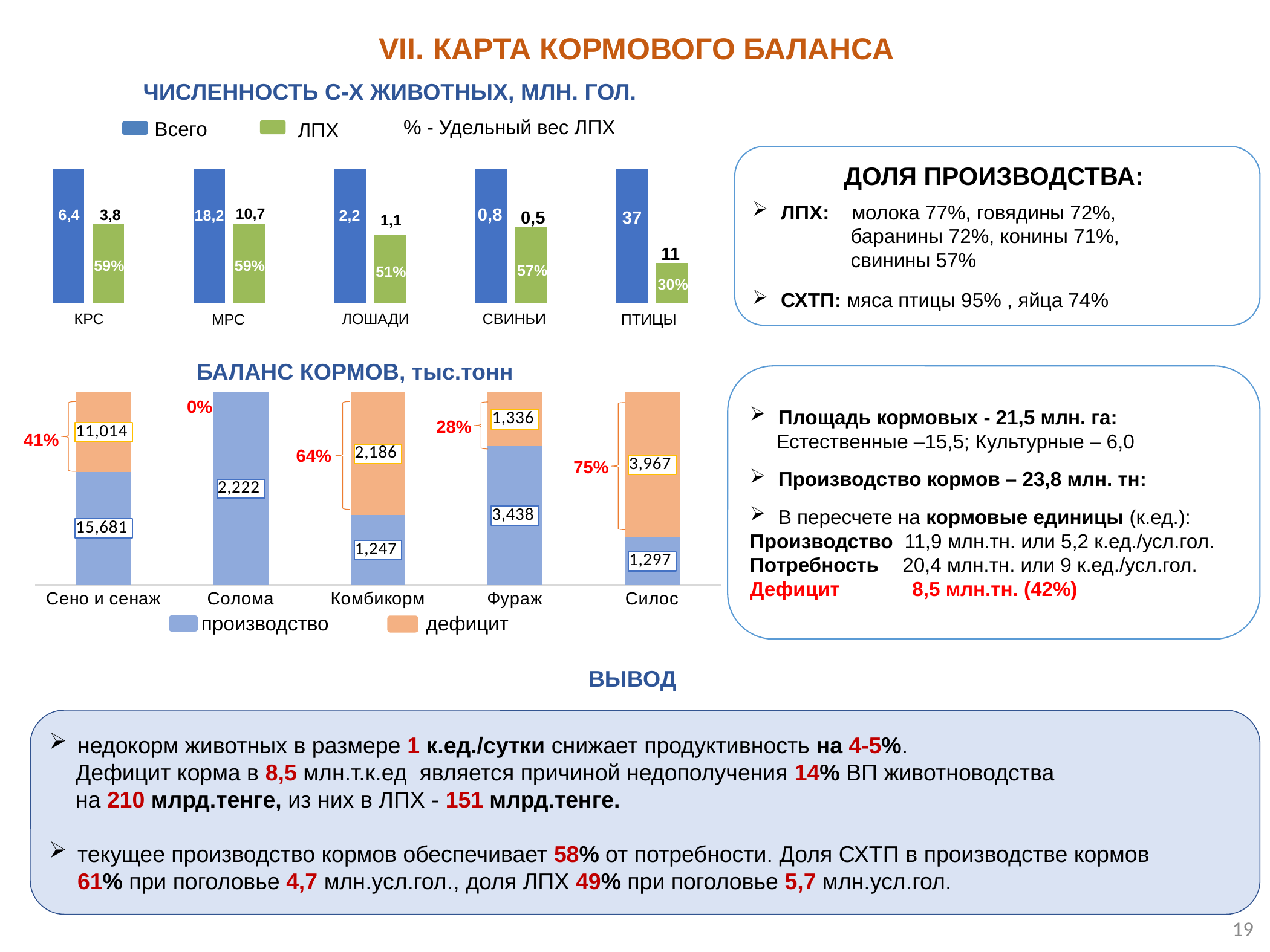
In the chart 'БАЛАНС КОРМОВ, тыс.тонн', what is the total of the stacked bar for Комбикорм? 3,433 In the chart 'БАЛАНС КОРМОВ, тыс.тонн', what is the 'дефицит' value for Силос? 3,967 In the chart 'ЧИСЛЕННОСТЬ С-Х ЖИВОТНЫХ, МЛН. ГОЛ.', which category has the lowest 'Всего' value? СВИНЬИ In the chart 'БАЛАНС КОРМОВ, тыс.тонн', what is the difference between 'производство' and 'дефицит' for Сено и сенаж? 4,667 In the chart 'ЧИСЛЕННОСТЬ С-Х ЖИВОТНЫХ, МЛН. ГОЛ.', what is the 'Всего' value for МРС? 18,2 What type of chart is 'БАЛАНС КОРМОВ, тыс.тонн'? Stacked bar chart In the chart 'ЧИСЛЕННОСТЬ С-Х ЖИВОТНЫХ, МЛН. ГОЛ.', how many animal categories are shown? 5 In the chart 'БАЛАНС КОРМОВ, тыс.тонн', which category has the highest 'производство' value? Сено и сенаж In the chart 'БАЛАНС КОРМОВ, тыс.тонн', what is the 'производство' value for Фураж? 3,438 In the chart 'ЧИСЛЕННОСТЬ С-Х ЖИВОТНЫХ, МЛН. ГОЛ.', how many series does the legend list? 2 In the chart 'ЧИСЛЕННОСТЬ С-Х ЖИВОТНЫХ, МЛН. ГОЛ.', what percentage share of ЛПХ is shown for ЛОШАДИ? 51% In the chart 'ЧИСЛЕННОСТЬ С-Х ЖИВОТНЫХ, МЛН. ГОЛ.', what is the 'ЛПХ' value for ПТИЦЫ? 11